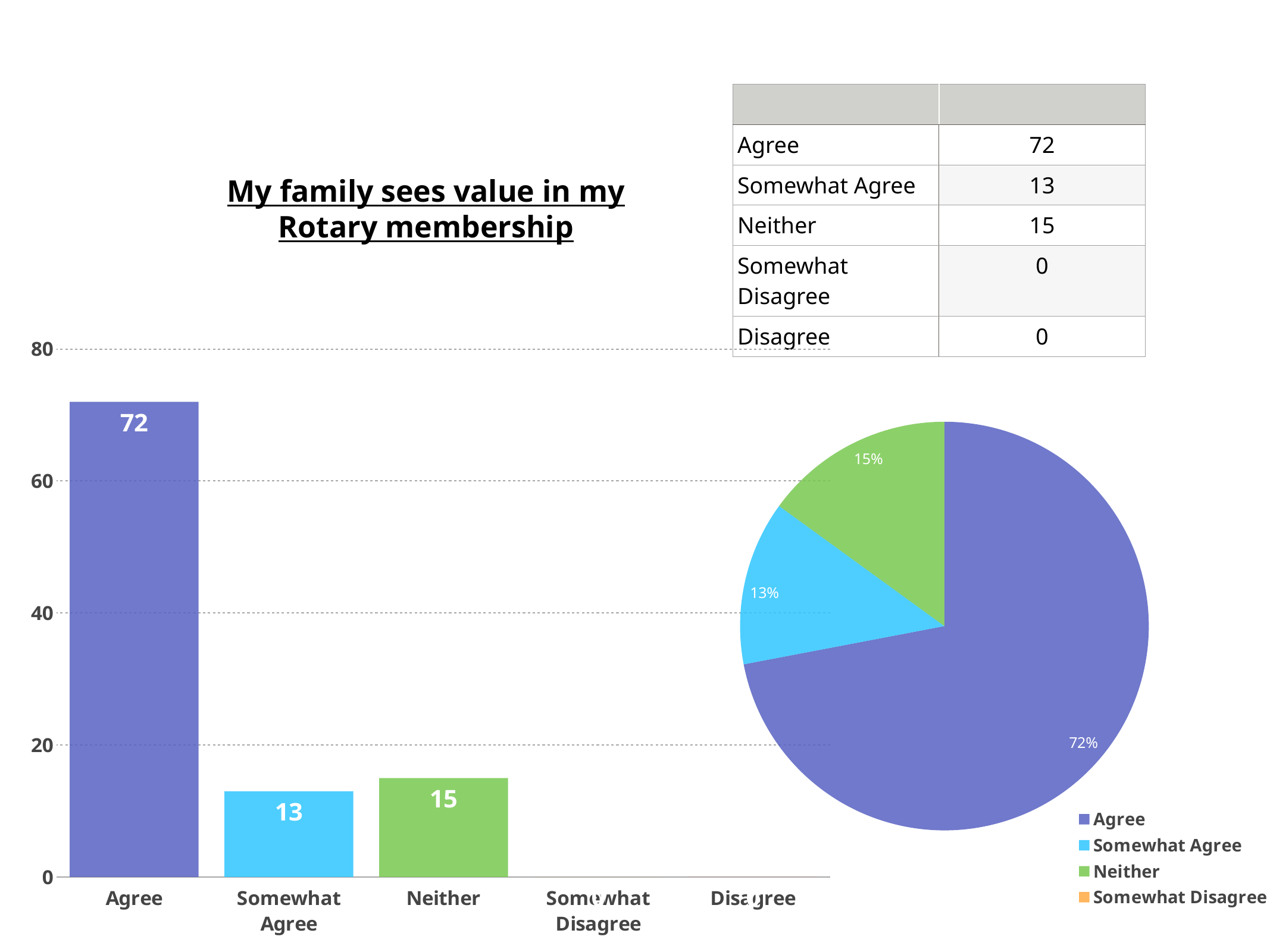
In the pie chart, what share does the Somewhat Agree slice have? 13% In the bar chart, which is larger, Somewhat Agree or Neither? Neither In the pie chart, what share does the Agree slice have? 72% In the bar chart, what is the value for Somewhat Agree? 13 In the bar chart, what is the value for Neither? 15 What kind of chart is the chart on the left of the slide? bar chart In the bar chart, what is the difference between the values for Agree and Neither? 57 In the bar chart, which category has the highest value? Agree How many entries does the legend of the pie chart list? 4 How many categories are shown on the x axis of the bar chart? 5 In the bar chart, is the value for Agree greater or less than 60? greater In the bar chart, what is the value for Agree? 72